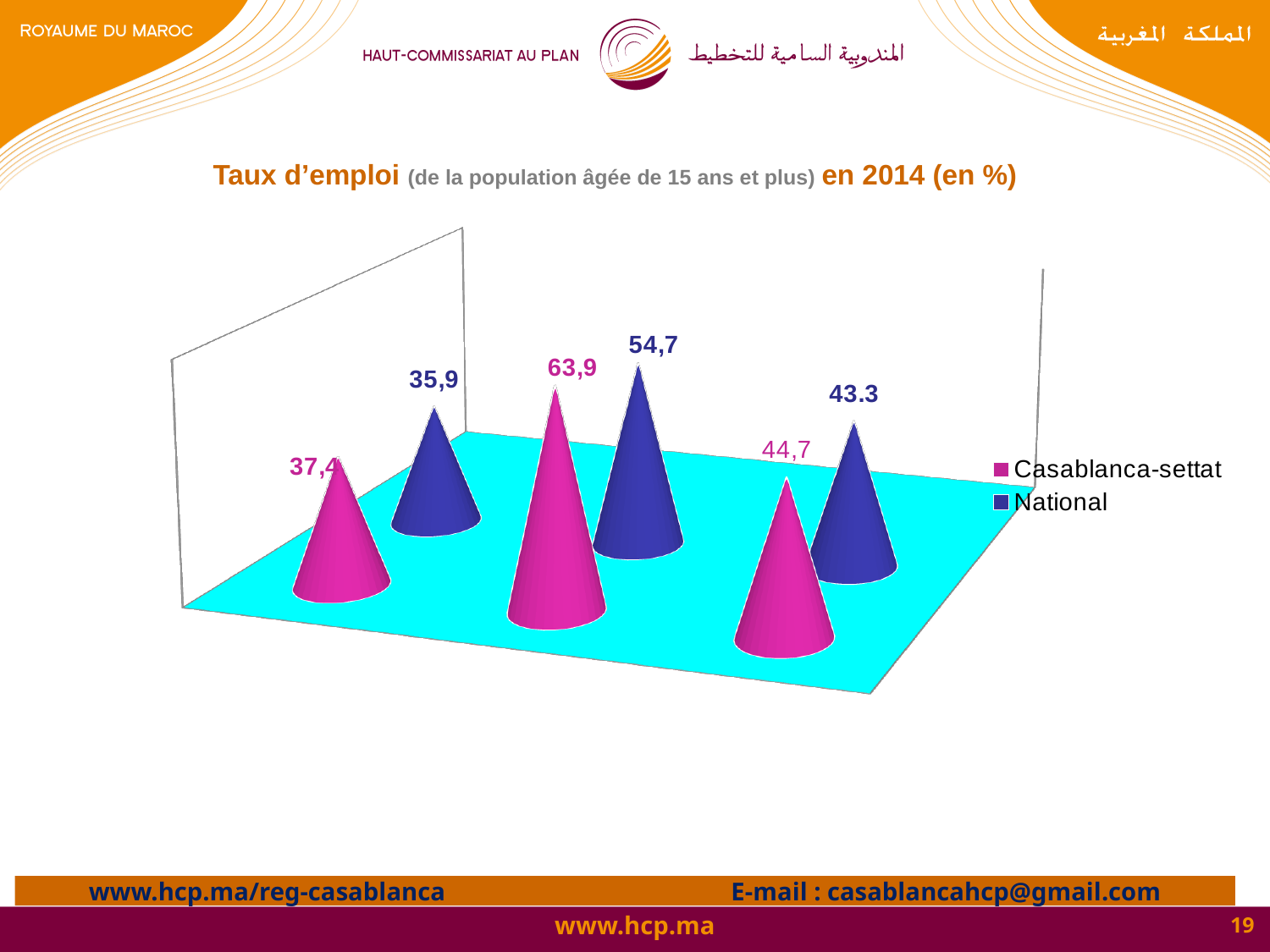
In the rightmost group of cones, which series has the larger value, Casablanca-settat or National? Casablanca-settat What colour are the cones for the Casablanca-settat series? magenta (pink) What kind of chart is shown on the slide? bar chart How many series does the legend list? 2 What is the value for National in the rightmost group of cones? 43.3 What is the highest value plotted for the Casablanca-settat series? 63,9 What is the value for National in the middle group of cones? 54,7 What is the value for Casablanca-settat in the middle group of cones? 63,9 In the middle group of cones, what is the difference between the Casablanca-settat value and the National value? 9,2 How many groups of cones (categories) are plotted in the chart? 3 What is the lowest value plotted for the National series? 35,9 What is the value for Casablanca-settat in the leftmost group of cones? 37,4